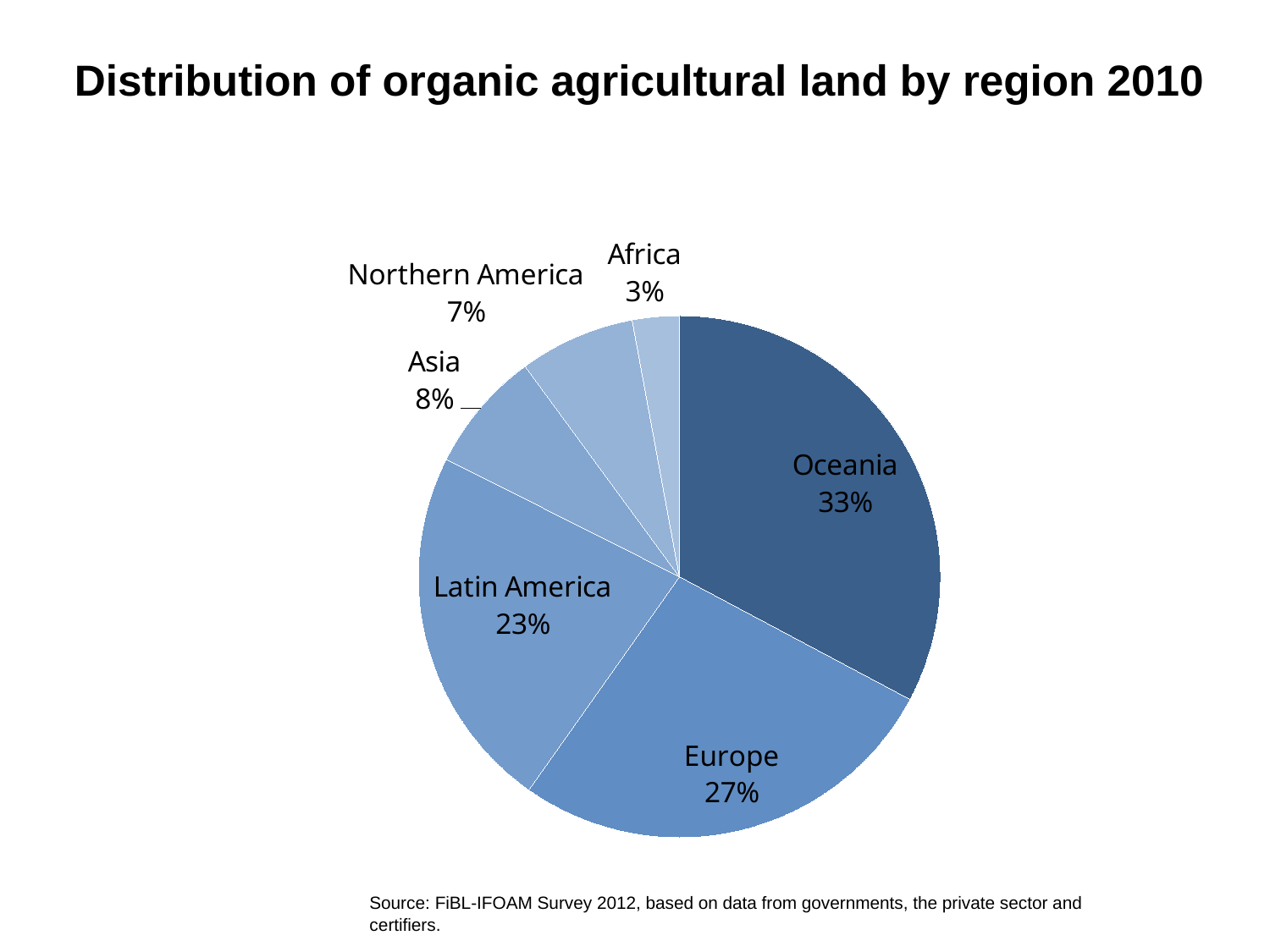
What share of organic agricultural land does Europe hold? 27% Which region has the largest share of organic agricultural land? Oceania What is the title of the chart? Distribution of organic agricultural land by region 2010 How many regions are shown in the pie chart? 6 Which has a larger share of organic agricultural land, Latin America or Europe? Europe How many percentage points larger is Oceania's share than Europe's? 6 What kind of chart is shown on the slide? Pie chart What share of organic agricultural land does Latin America hold? 23% What share of organic agricultural land does Oceania hold? 33% What share of organic agricultural land does Northern America hold? 7% What share of organic agricultural land does Asia hold? 8% Which region has the smallest share of organic agricultural land? Africa